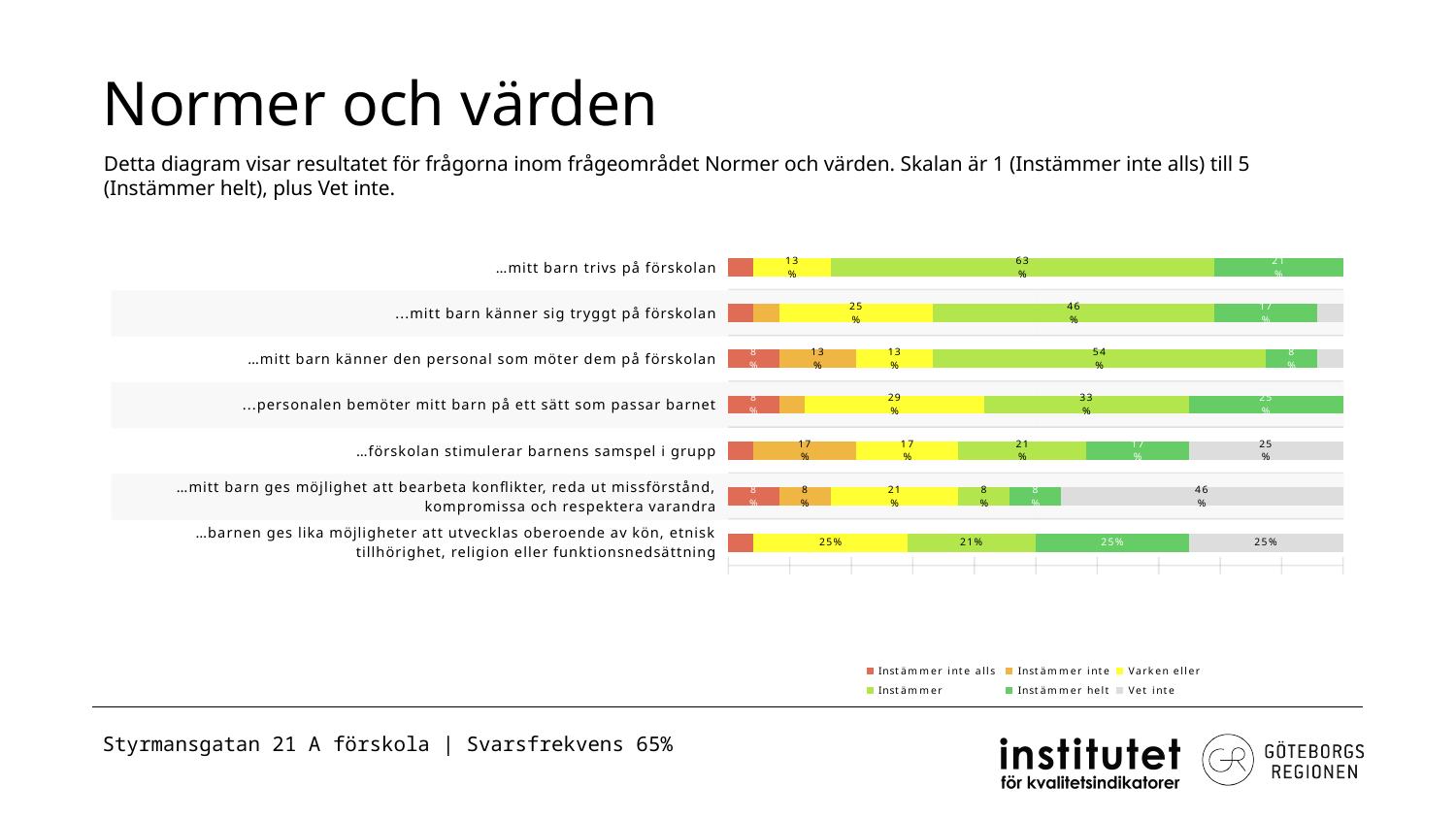
What is the title of the slide containing the chart? Normer och värden What is the 'Instämmer' share for '…mitt barn känner den personal som möter dem på förskolan'? 54% What is the difference between the 'Instämmer' share for '…mitt barn trivs på förskolan' and for '…mitt barn känner sig tryggt på förskolan'? 17% Which is larger: the 'Vet inte' share for '…förskolan stimulerar barnens samspel i grupp' or for '…mitt barn ges möjlighet att bearbeta konflikter, reda ut missförstånd, kompromissa och respektera varandra'? …mitt barn ges möjlighet att bearbeta konflikter, reda ut missförstånd, kompromissa och respektera varandra How many series does the legend list? 6 What is the 'Instämmer helt' share for '…personalen bemöter mitt barn på ett sätt som passar barnet'? 25% What is the 'Instämmer' share for '…mitt barn trivs på förskolan'? 63% How many question categories are plotted in the chart? 7 What kind of chart is shown on the slide? stacked bar chart Which category has the highest 'Instämmer' share? …mitt barn trivs på förskolan What is the 'Varken eller' share for '…mitt barn känner sig tryggt på förskolan'? 25% What is the 'Vet inte' share for '…mitt barn ges möjlighet att bearbeta konflikter, reda ut missförstånd, kompromissa och respektera varandra'? 46%